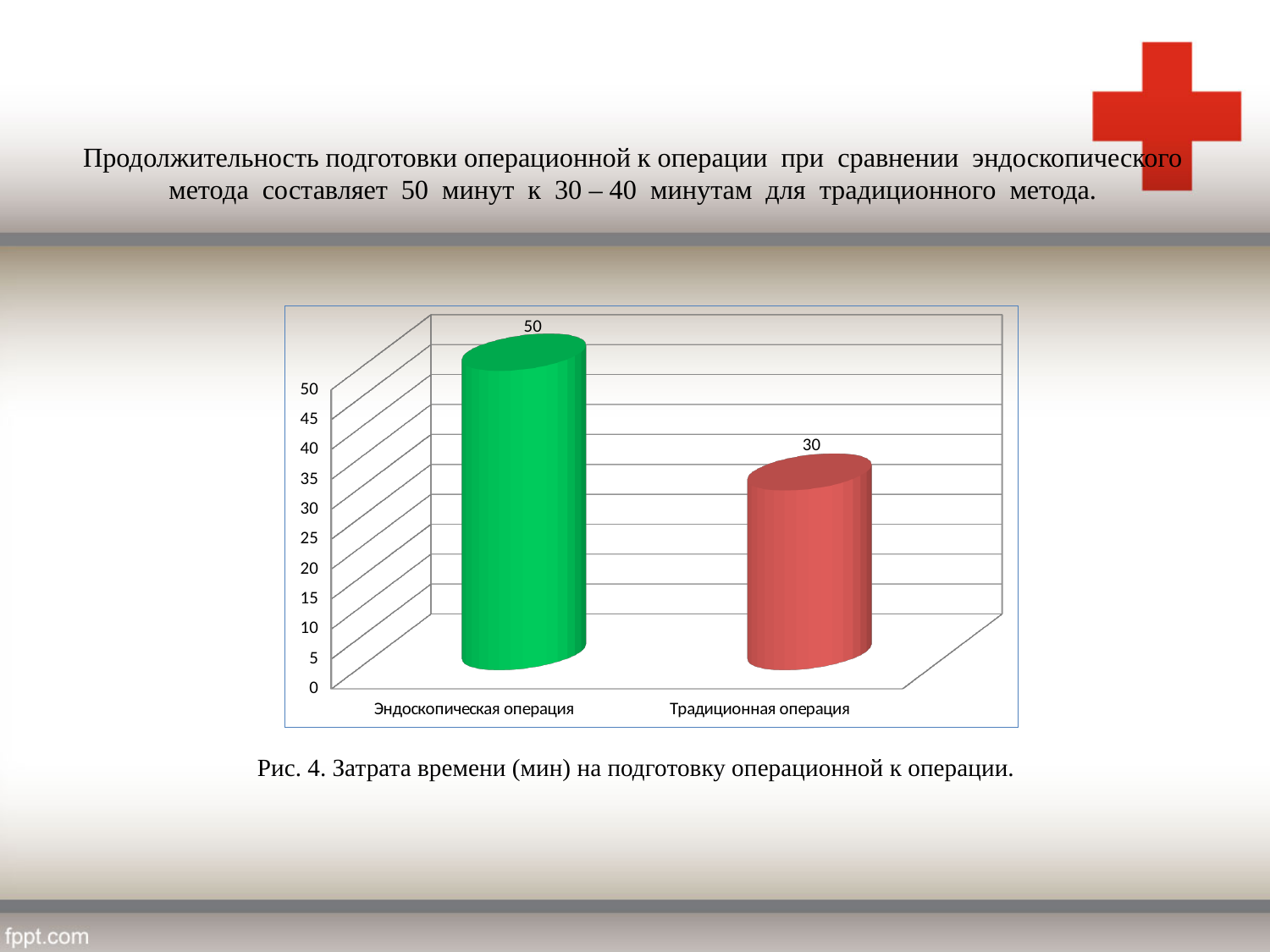
What is the caption of the figure below the chart? Рис. 4. Затрата времени (мин) на подготовку операционной к операции. What colour is the bar for Традиционная операция? red What is the difference between the values for Эндоскопическая операция and Традиционная операция? 20 What kind of chart is shown on the slide? bar chart How many categories are shown on the chart? 2 Which category has the highest value? Эндоскопическая операция Which is larger, the value for Эндоскопическая операция or for Традиционная операция? Эндоскопическая операция What is the value for Эндоскопическая операция? 50 Which category has the lowest value? Традиционная операция What is the total of the two values shown on the chart? 80 Is the value for Традиционная операция greater or less than 40? less What is the value for Традиционная операция? 30